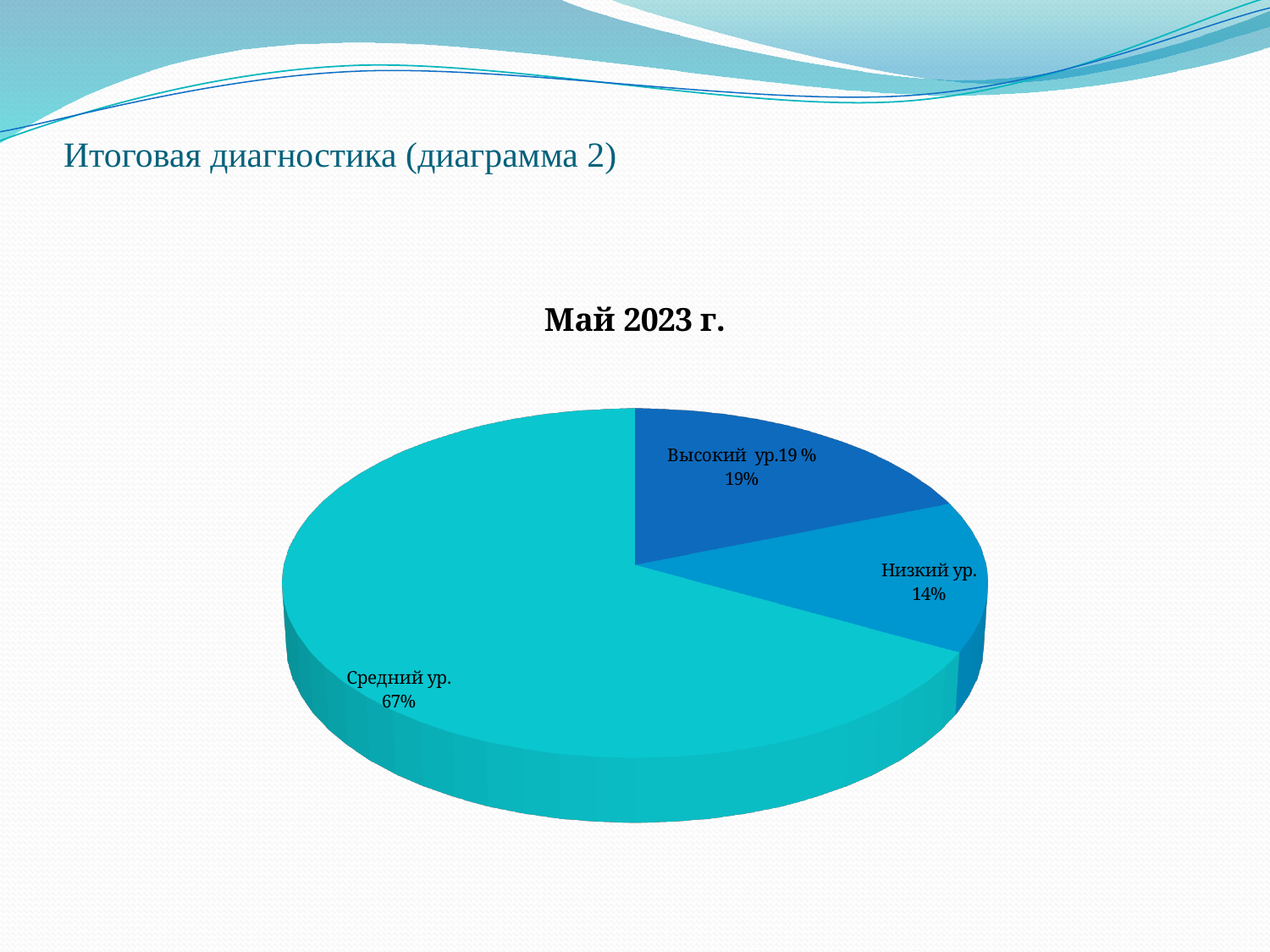
What percentage does the Высокий ур. slice show? 19% What percentage does the Низкий ур. slice show? 14% What type of chart is shown on the slide? Pie chart Which category has the largest share of the pie? Средний ур. What percentage does the Средний ур. slice show? 67% What is the title of the chart? Май 2023 г. Which category has the smallest share of the pie? Низкий ур. What is the difference in percentage points between Высокий ур. and Низкий ур.? 5 Which is larger, the share for Высокий ур. or the share for Низкий ур.? Высокий ур. How many slices does the pie chart have? 3 Is the share for Средний ур. greater or less than 50%? greater What is the difference in percentage points between Средний ур. and Высокий ур.? 48